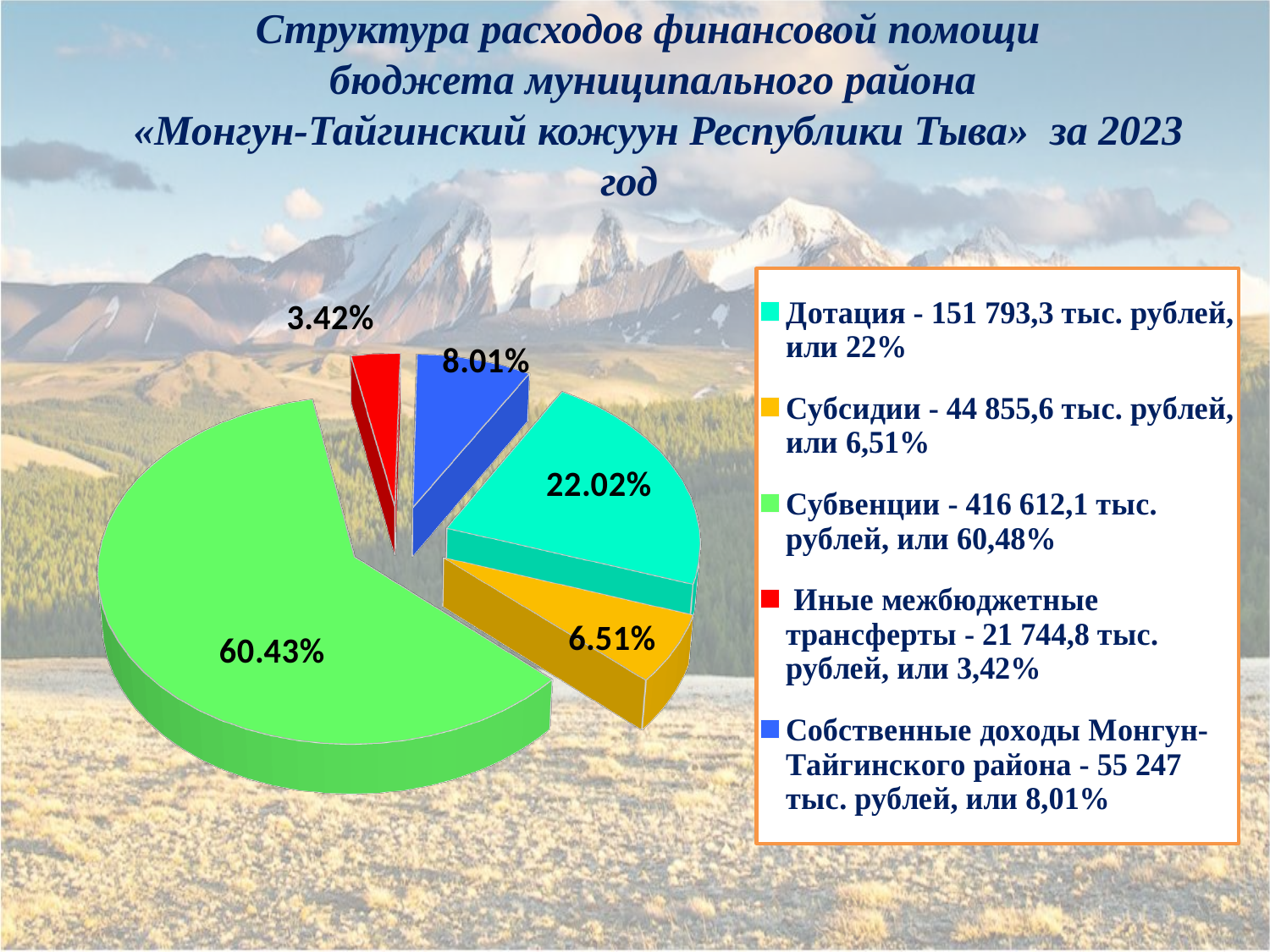
What percentage is shown on the pie chart for the red slice (Иные межбюджетные трансферты)? 3.42% Which category has the smallest share of the pie? Иные межбюджетные трансферты What kind of chart is shown on the slide? pie chart Which category has the largest share of the pie? Субвенции How many entries does the legend list? 5 Which is larger: the share for Субсидии or the share for Собственные доходы Монгун-Тайгинского района? Собственные доходы Монгун-Тайгинского района How many slices does the pie chart have? 5 What percentage is shown on the pie chart for the cyan slice (Дотация)? 22.02% According to the legend, what amount in тыс. рублей is given for Дотация? 151 793,3 тыс. рублей What percentage is shown on the pie chart for the blue slice (Собственные доходы Монгун-Тайгинского района)? 8.01% What percentage is shown on the pie chart for the green slice (Субвенции)? 60.43% What percentage is shown on the pie chart for the yellow slice (Субсидии)? 6.51%